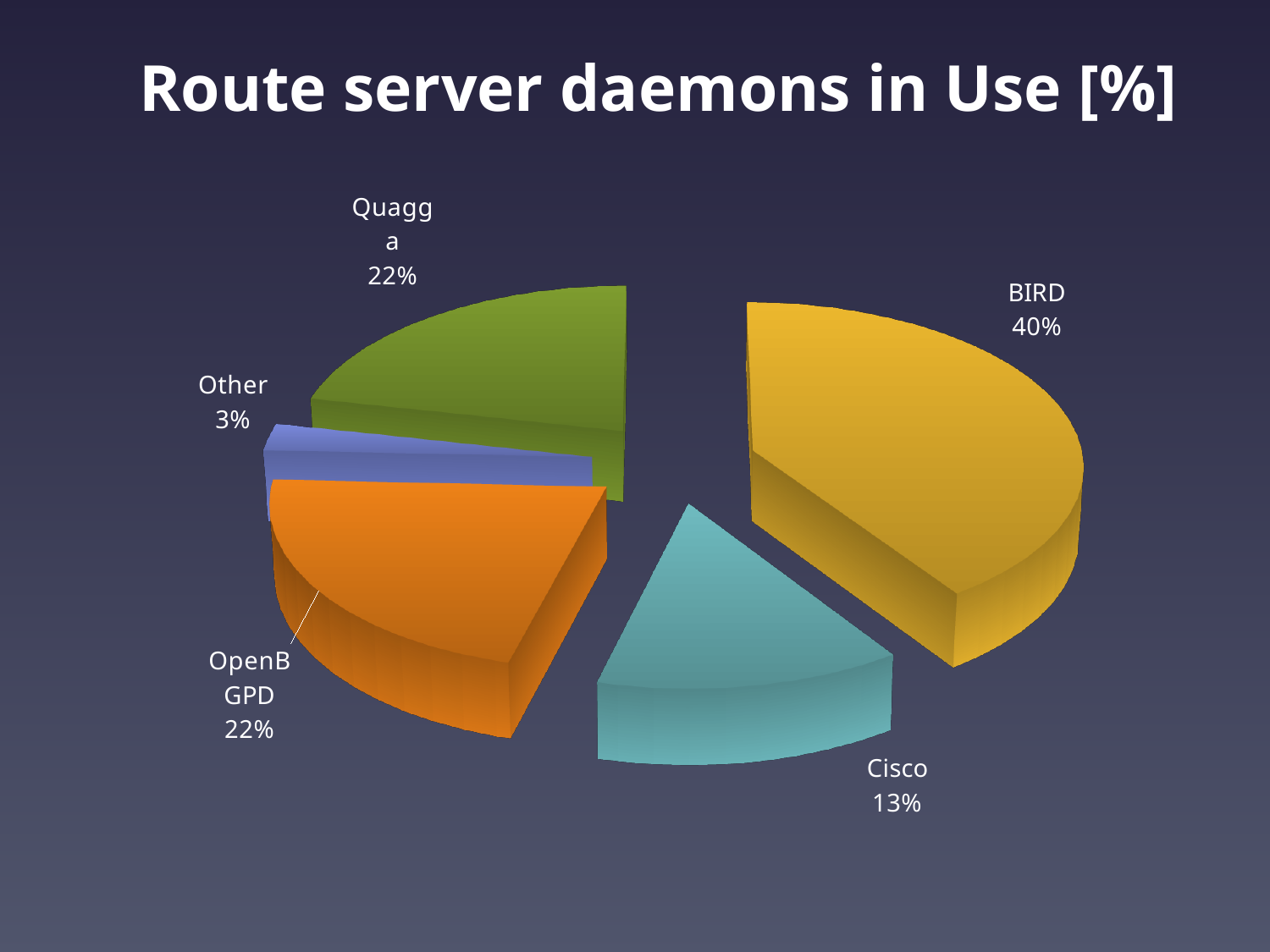
Which is larger, the share for Cisco or the share for OpenBGPD? OpenBGPD What kind of chart is shown on the slide? Pie chart What is the value shown for Quagga? 22% How many categories are shown in the pie chart? 5 What is the value shown for Other? 3% What is the title of the chart? Route server daemons in Use [%] Which route server daemon has the largest share? BIRD What is the value shown for Cisco? 13% What colour is the BIRD slice? Yellow What is the difference in percentage points between BIRD and Cisco? 27 Which category has the smallest share? Other What share of the pie does BIRD have? 40%